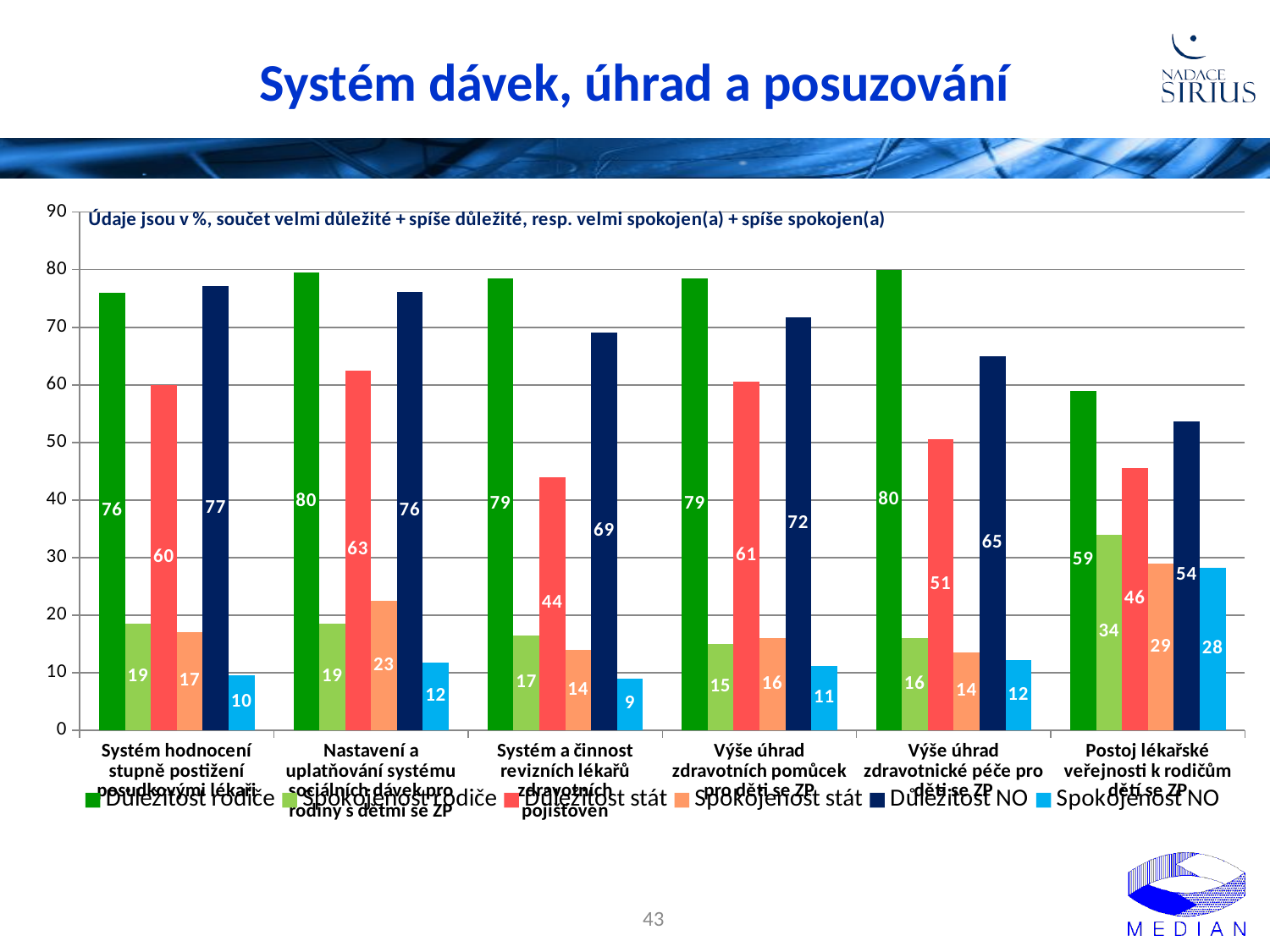
Is the value of Důležitost stát for Systém a činnost revizních lékařů zdravotních pojišťoven greater or less than 50? less For Nastavení a uplatňování systému sociálních dávek pro rodiny s dětmi se ZP, which is larger: Důležitost rodiče or Důležitost NO? Důležitost rodiče What kind of chart is shown on the slide? bar chart Which category has the lowest value for Spokojenost NO? Systém a činnost revizních lékařů zdravotních pojišťoven How many categories are shown on the x axis? 6 Which category has the highest value for Spokojenost rodiče? Postoj lékařské veřejnosti k rodičům dětí se ZP Which series is shown in dark blue in the legend? Důležitost NO What is the value of Důležitost rodiče for Systém a činnost revizních lékařů zdravotních pojišťoven? 79 How many series does the legend list? 6 What is the value of Spokojenost NO for Postoj lékařské veřejnosti k rodičům dětí se ZP? 28 What is the difference between Důležitost NO and Spokojenost NO for Systém hodnocení stupně postižení posudkovými lékaři? 67 What is the value of Důležitost stát for Výše úhrad zdravotnické péče pro děti se ZP? 51